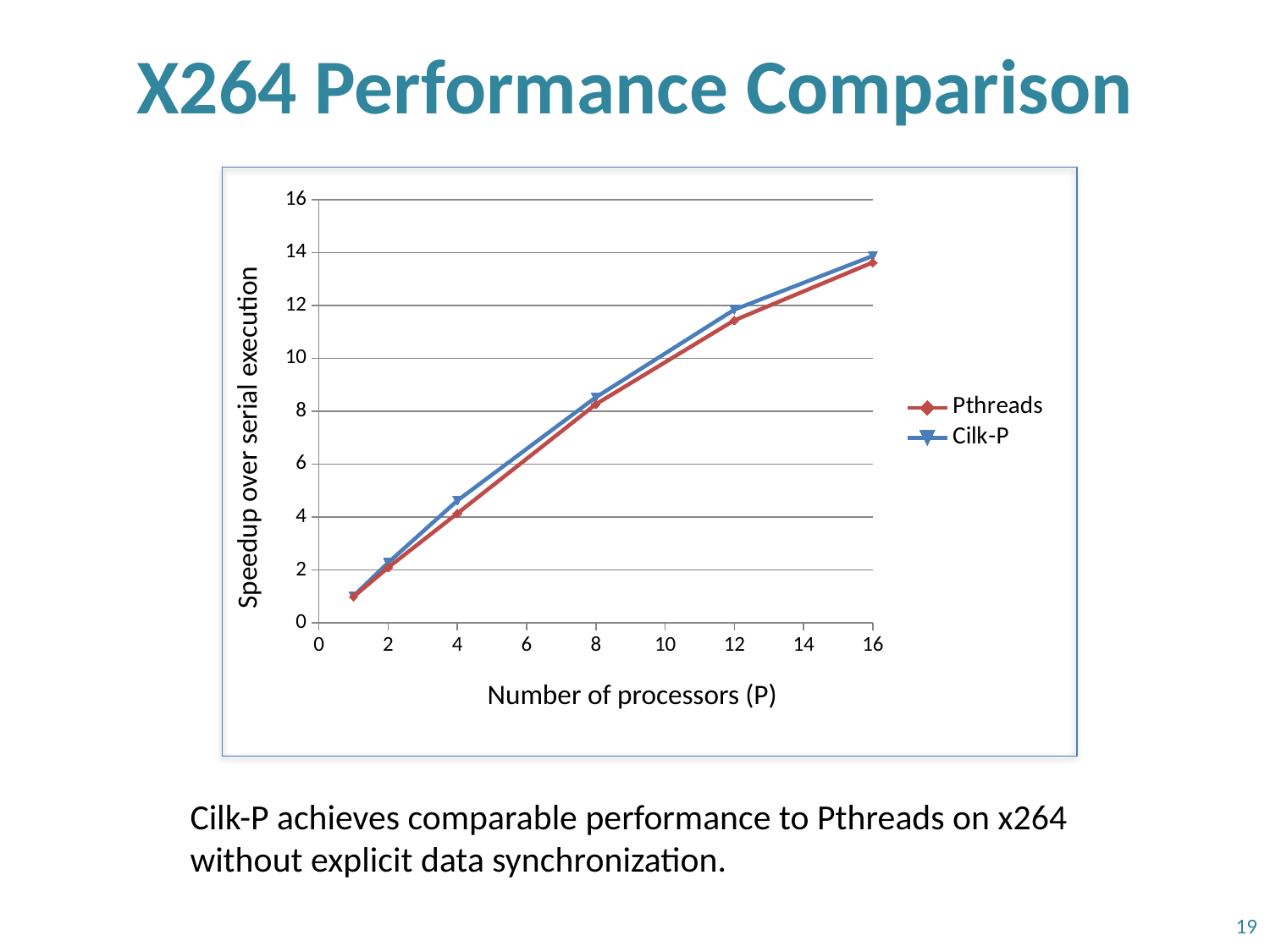
How many data points are plotted for the Cilk-P series? 6 Is the Pthreads speedup at 8 processors greater or less than 6? greater What is the label of the x axis? Number of processors (P) Is the Pthreads speedup at 12 processors greater or less than 10? greater At 4 processors, which series has the higher speedup, Pthreads or Cilk-P? Cilk-P How many series does the legend list? 2 Which two series are listed in the legend? Pthreads and Cilk-P Is the Cilk-P speedup at 4 processors greater or less than 6? less For the Pthreads series, at which number of processors is the speedup highest? 16 Does the speedup for Pthreads rise or fall as the number of processors increases? rise What kind of chart is shown on the slide? line chart